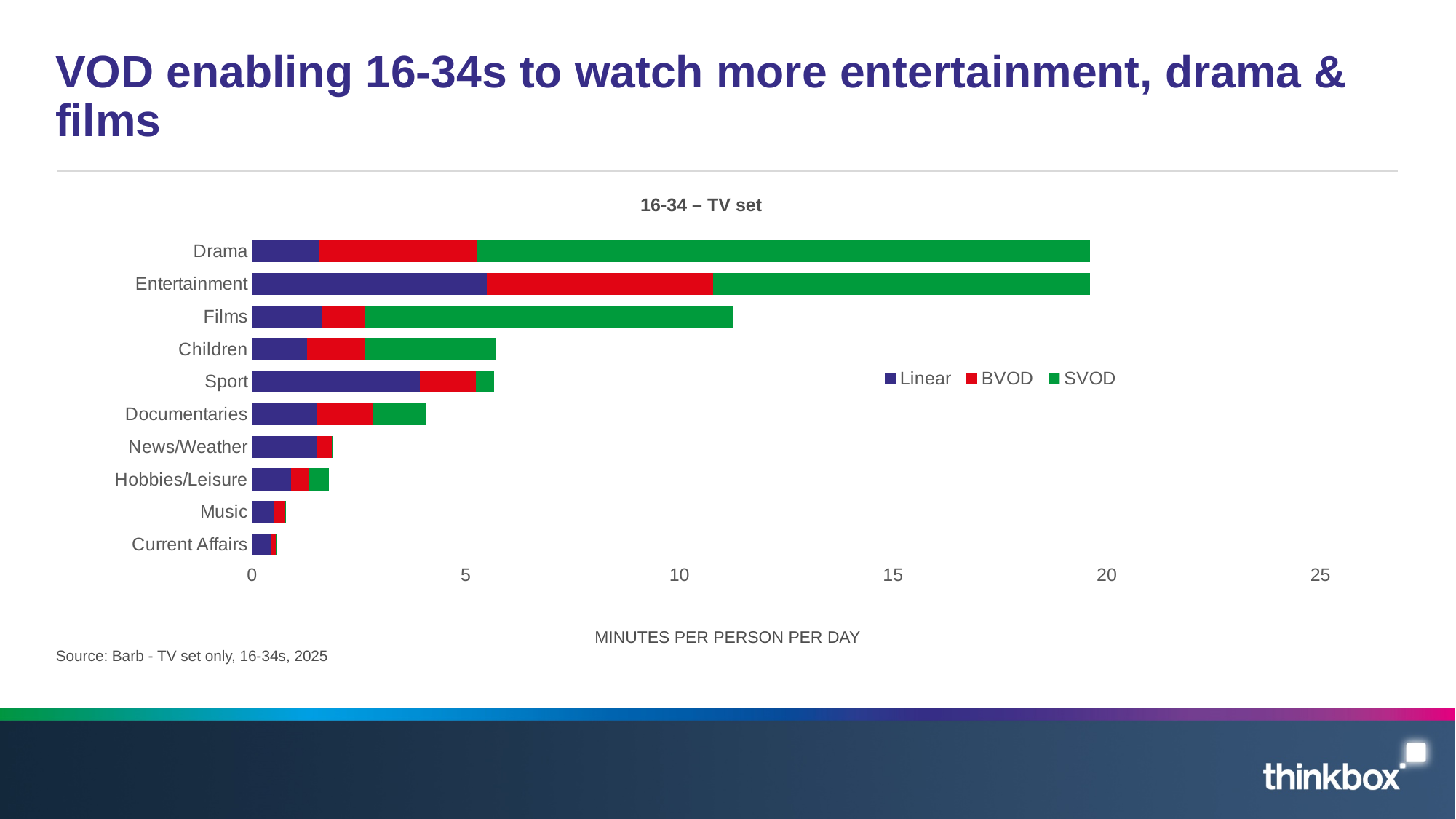
How many categories (genres) are plotted on the chart? 10 Is the total value for Children greater or less than 5? greater How many series does the legend list? 3 What is the label on the horizontal axis of the chart? MINUTES PER PERSON PER DAY Which has a larger total, Films or Children? Films Is the total value for Films greater or less than 10? greater Is the total value for Documentaries greater or less than 5? less Which category has the lowest total minutes per person per day? Current Affairs Which has a larger total, Sport or Documentaries? Sport What kind of chart is shown on the slide? Stacked bar chart What are the three series named in the legend? Linear, BVOD, SVOD